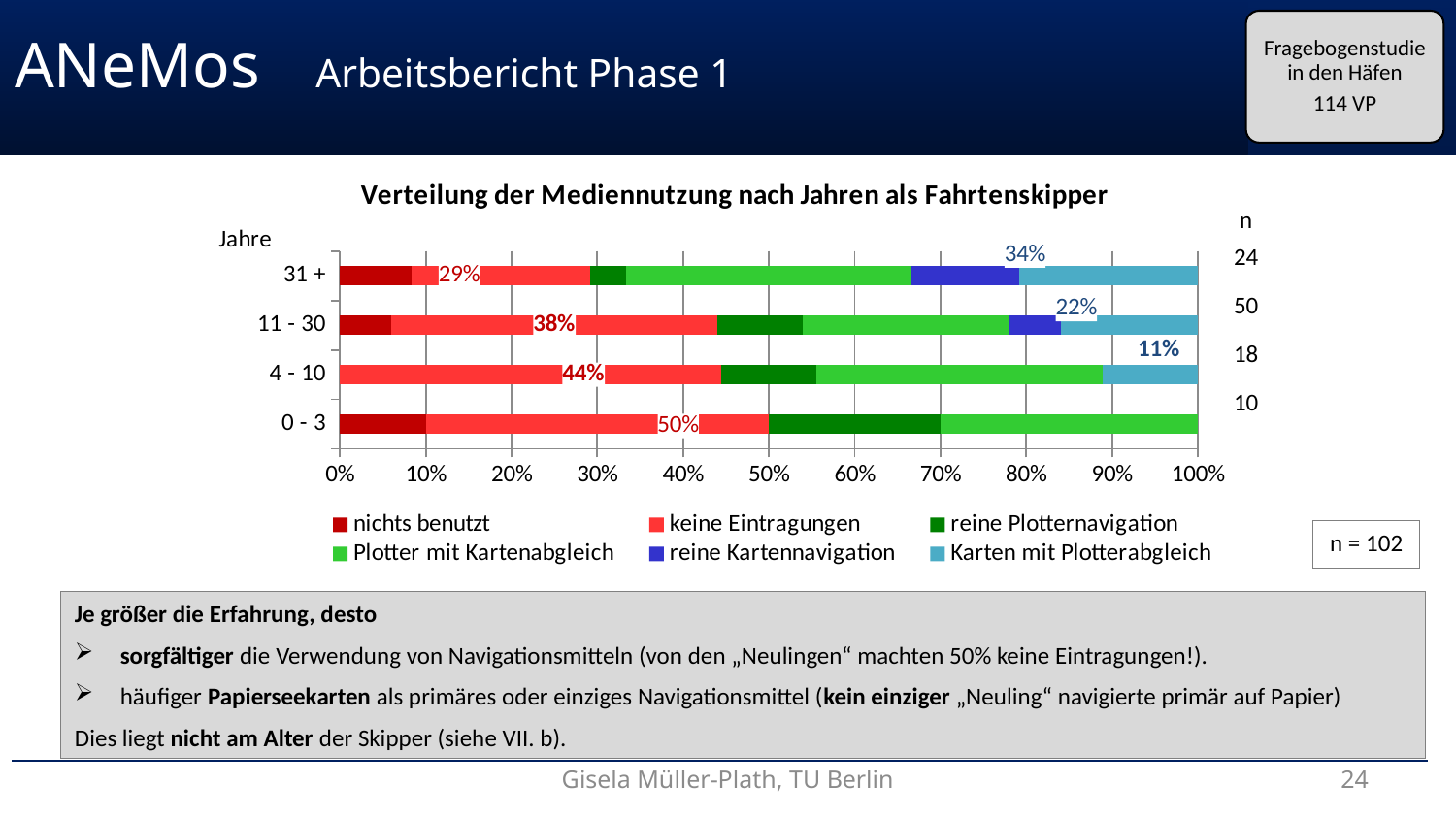
How many series does the legend list? 6 What kind of chart is shown on the slide? bar chart What is the title of the chart? Verteilung der Mediennutzung nach Jahren als Fahrtenskipper Is the share of "Karten mit Plotterabgleich" larger for the 31 + category or the 4 - 10 category? 31 + How many year categories (Jahre) are plotted on the chart? 4 Which year category has the highest share of "keine Eintragungen"? 4 - 10 Which year category has the lowest share of "keine Eintragungen"? 31 +